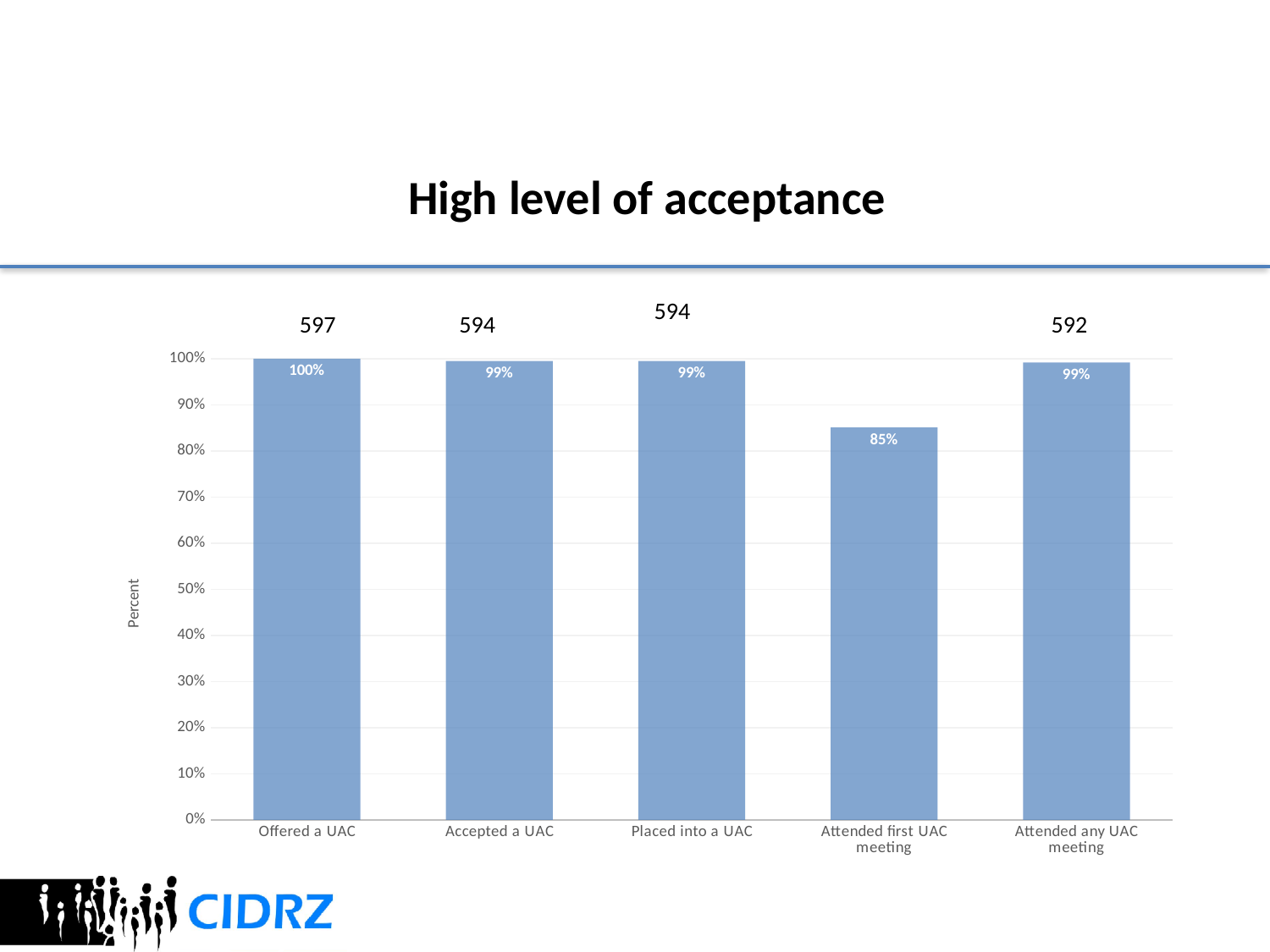
Which is larger, the value for 'Placed into a UAC' or the value for 'Attended first UAC meeting'? Placed into a UAC What percentage is shown for 'Accepted a UAC'? 99% Which category has the highest percentage? Offered a UAC What kind of chart is shown on the slide? Bar chart Which category has the lowest percentage? Attended first UAC meeting How many categories are shown on the x axis? 5 Is the value for 'Attended first UAC meeting' greater or less than 90%? less What is the title of the slide? High level of acceptance What is the label on the y axis? Percent What is the difference in percentage points between 'Offered a UAC' and 'Attended first UAC meeting'? 15 What percentage is shown for 'Attended first UAC meeting'? 85% What percentage is shown for 'Offered a UAC'? 100%